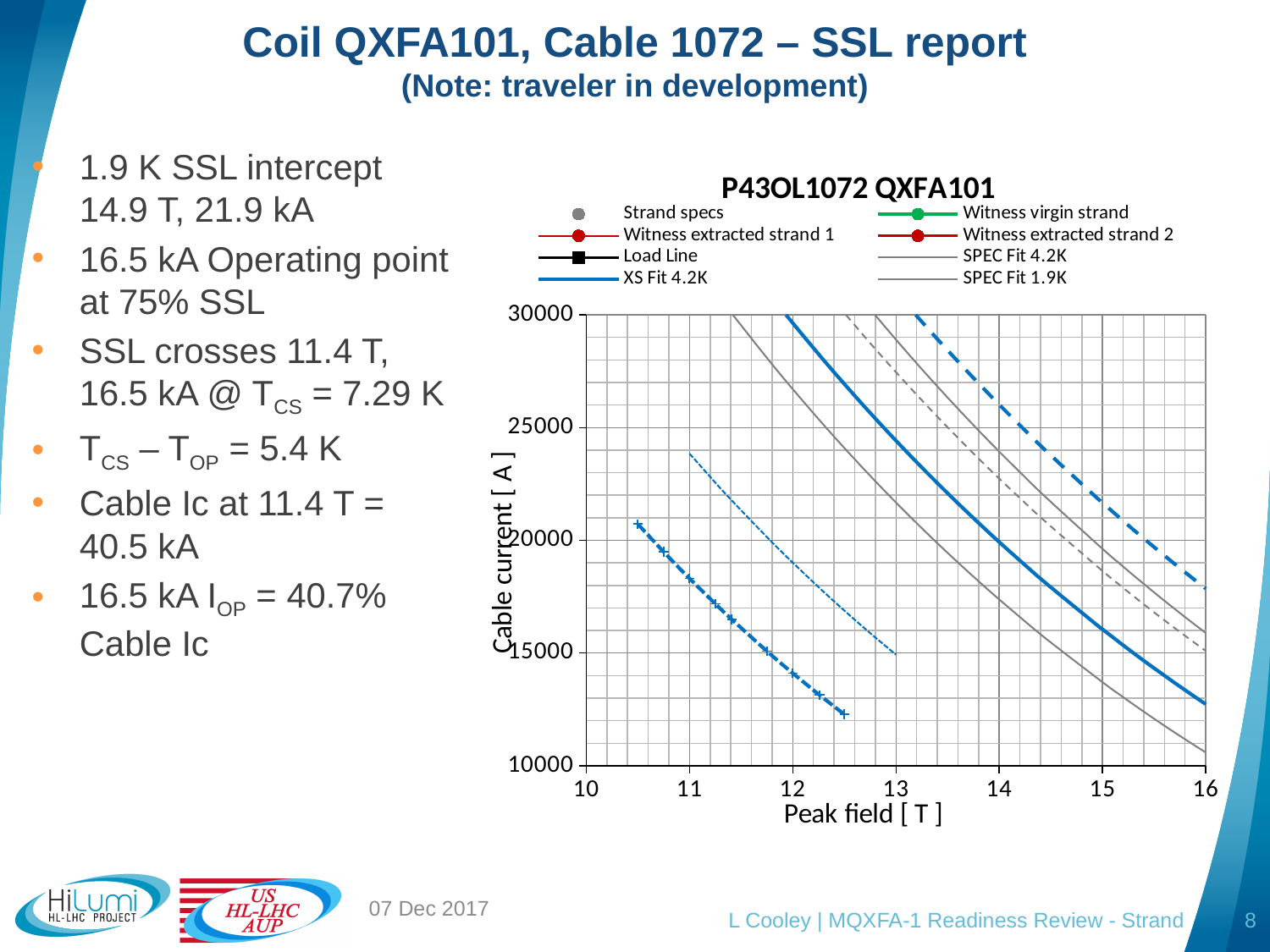
What kind of chart is shown on the slide? line chart What is the title of the chart? P43OL1072 QXFA101 What is the label of the chart's x axis? Peak field [ T ] Is the value of the thick dashed blue curve at 16 T greater or less than 15000? greater At 16 T, which is larger: the XS Fit 4.2K curve or the thick dashed blue curve? the thick dashed blue curve Do the plotted curves rise or fall as peak field increases along the x axis? fall Is the value of the thick dashed blue curve at 16 T greater or less than 20000? less Is the value of the XS Fit 4.2K curve at 16 T greater or less than 15000? less How many series does the chart legend list? 8